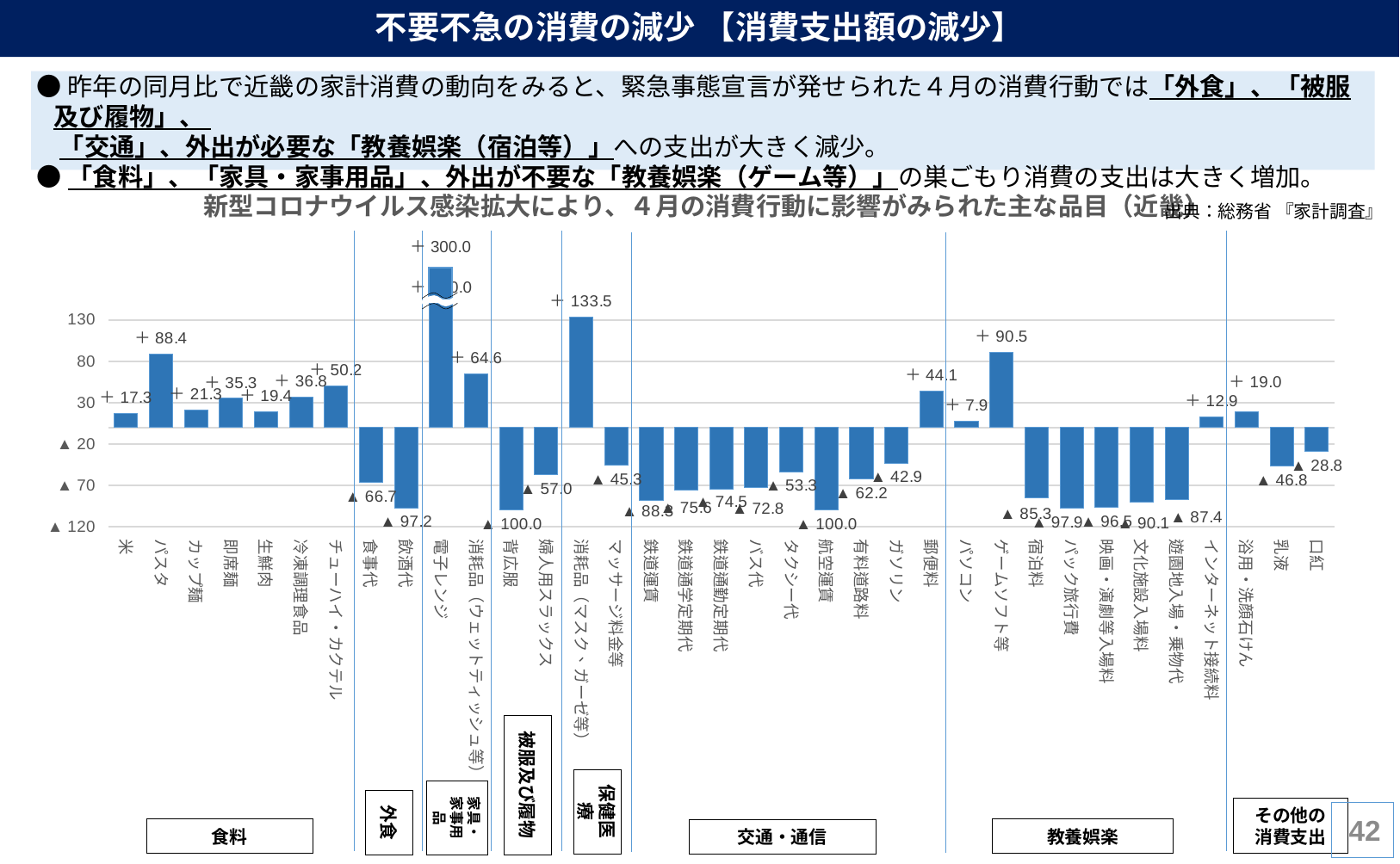
What is the value shown for パスタ? +88.4 What kind of chart is shown on the slide? Bar chart How many items (bars) are plotted in the chart? 35 Which has the larger value, 郵便料 or パソコン? 郵便料 What is the value shown for 口紅? ▲28.8 What is the value shown for ゲームソフト等? +90.5 What is the value shown for 消耗品（マスク・ガーゼ等）? +133.5 What is the difference between the values for パスタ and 米? 71.1 Which item has the highest value in the chart? 電子レンジ What is the value shown for 航空運賃? ▲100.0 What is the value shown for 飲酒代? ▲97.2 What is the difference between the values for ゲームソフト等 and パソコン? 82.6